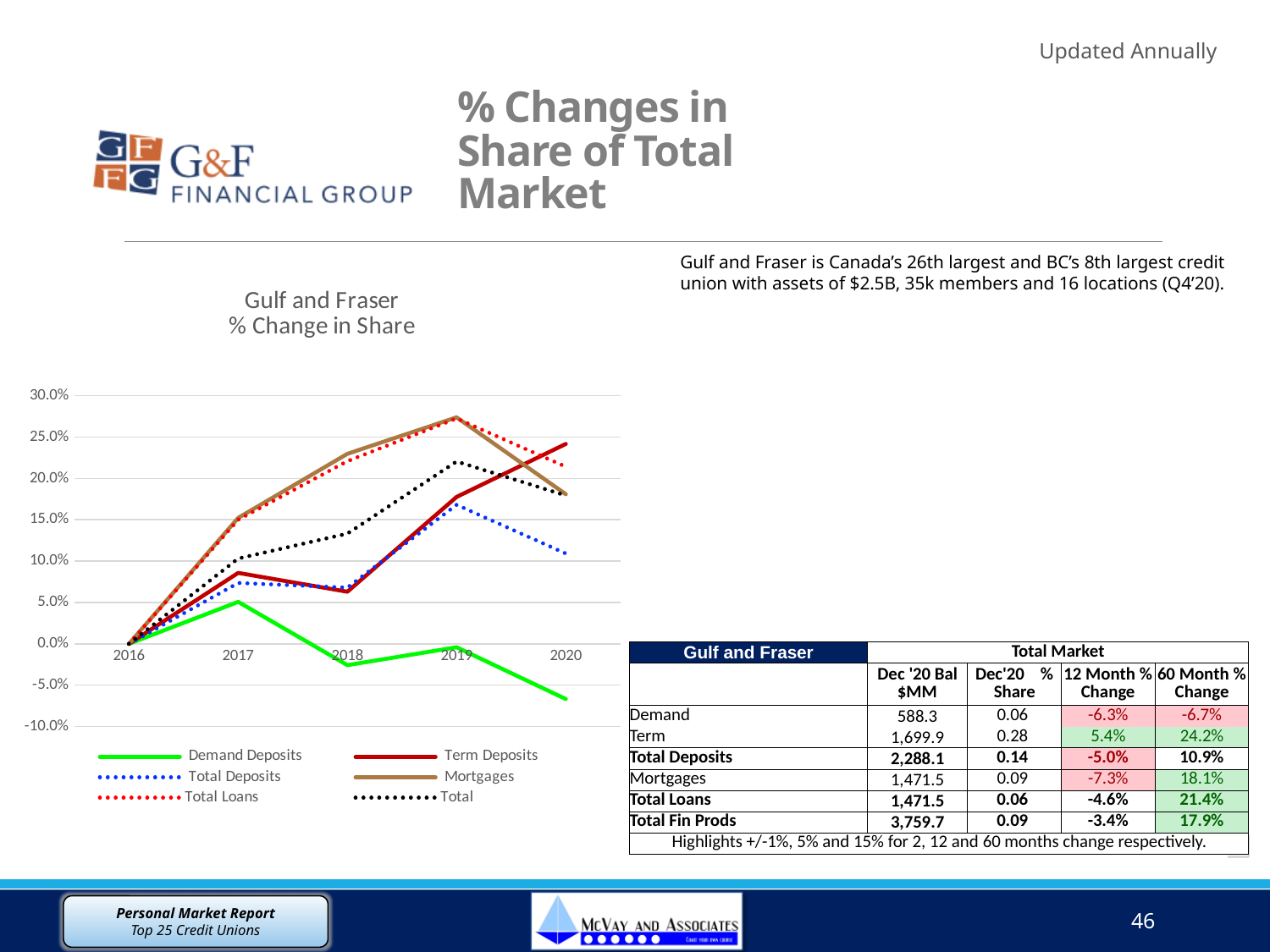
What kind of chart is shown on the slide? line chart How many series does the chart legend list? 6 What is the title of the chart? Gulf and Fraser % Change in Share Does the Term Deposits line rise or fall from 2016 to 2020? rise Is the value for Total Deposits in 2020 greater or less than 15.0%? less Is the value for Mortgages in 2019 greater or less than 25.0%? greater In 2018, which is larger: Mortgages or Total Deposits? Mortgages Is the value for Demand Deposits in 2020 greater or less than -5.0%? less Which series has the highest value in 2020? Term Deposits Which series has the lowest value in 2020? Demand Deposits How many years are shown along the x axis of the chart? 5 Which series is drawn as a solid green line in the chart? Demand Deposits